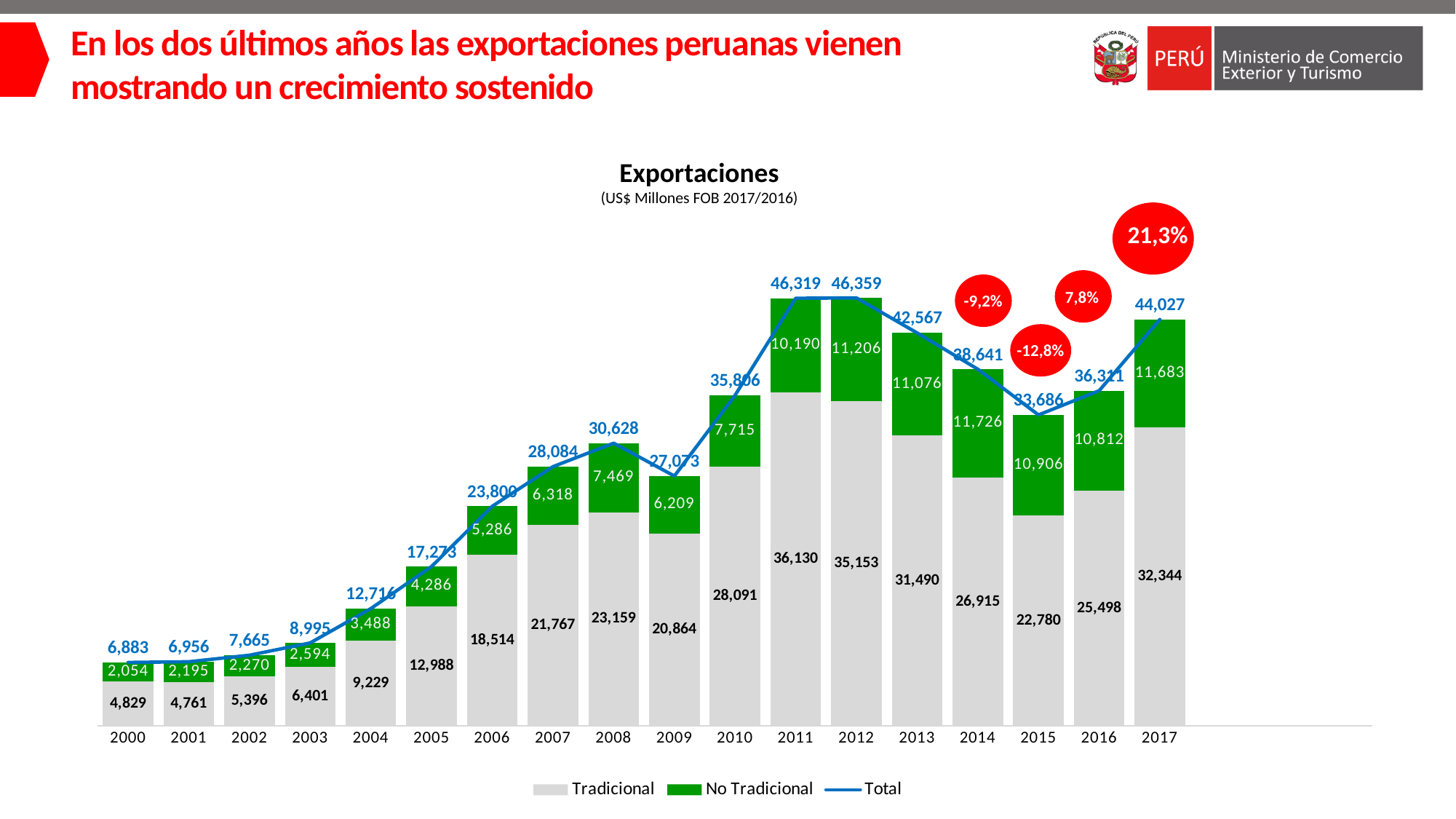
What is the difference between the Tradicional values for 2017 and 2016? 6,846 Which year has the highest Tradicional export value? 2011 Which is larger, the No Tradicional value for 2014 or for 2015? 2014 What is the Total export value shown for 2008? 30,628 What kind of chart is used to show the Tradicional and No Tradicional values? Stacked bar chart with a line for Total Which year has the lowest Tradicional export value? 2001 What is the Tradicional export value for 2005? 12,988 What is the Tradicional export value for 2017? 32,344 How many years are shown on the x axis? 18 How many series does the legend list? 3 What is the No Tradicional export value for 2012? 11,206 What percentage growth is shown in the largest red circle for 2017? 21,3%